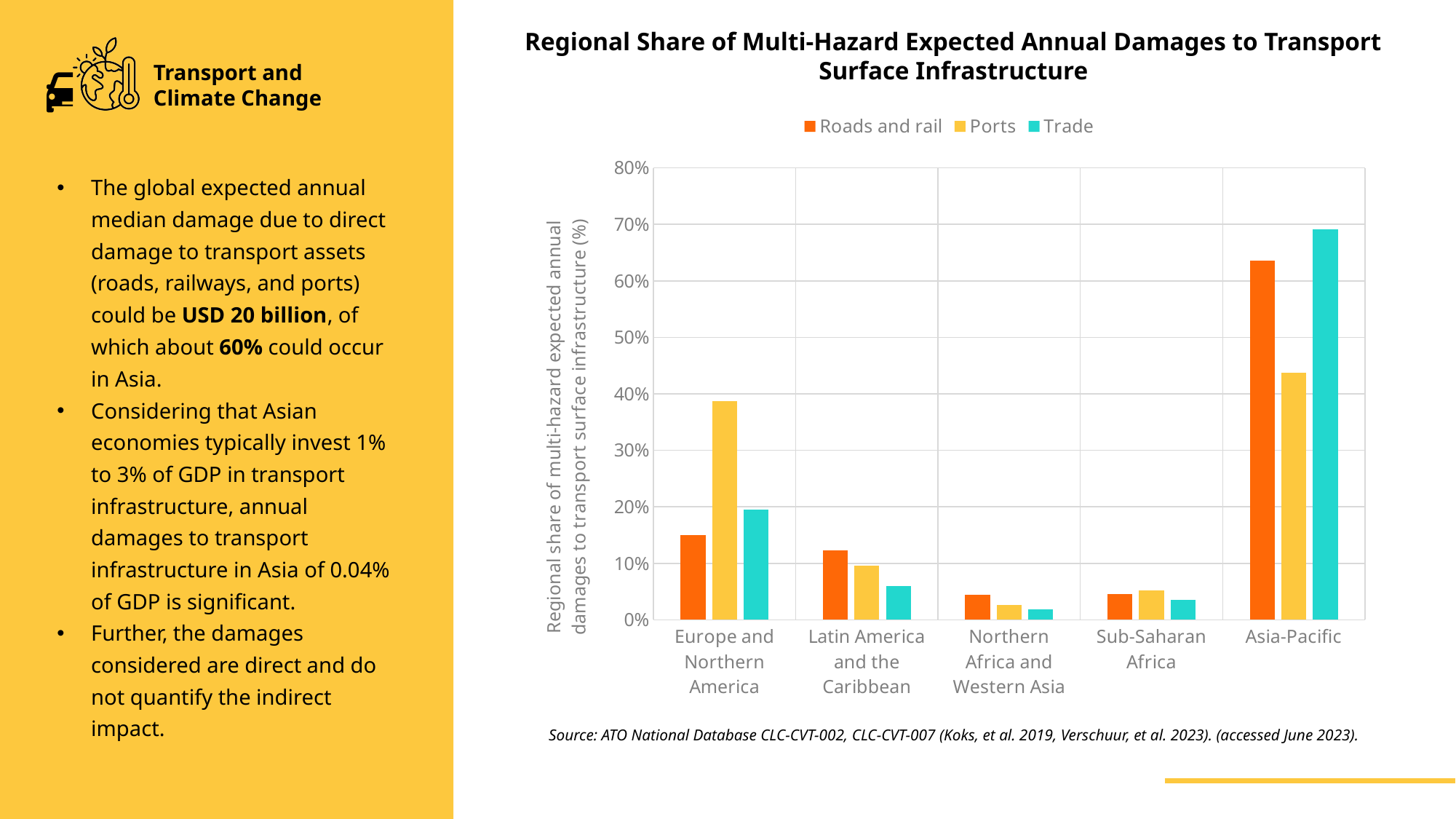
Is the Trade value for Asia-Pacific greater or less than 60%? greater Is the Roads and rail value for Latin America and the Caribbean greater or less than 10%? greater For Asia-Pacific, which is larger: Roads and rail or Ports? Roads and rail What kind of chart is shown on the slide? Bar chart How many series does the legend list? 3 For Europe and Northern America, which is larger: Ports or Trade? Ports Which region has the highest Trade value? Asia-Pacific How many regions are shown on the x axis? 5 What is the highest tick value shown on the y axis? 80% Is the Ports value for Europe and Northern America greater or less than 30%? greater Which region has the lowest Ports value? Northern Africa and Western Asia What are the three series named in the legend? Roads and rail, Ports, Trade